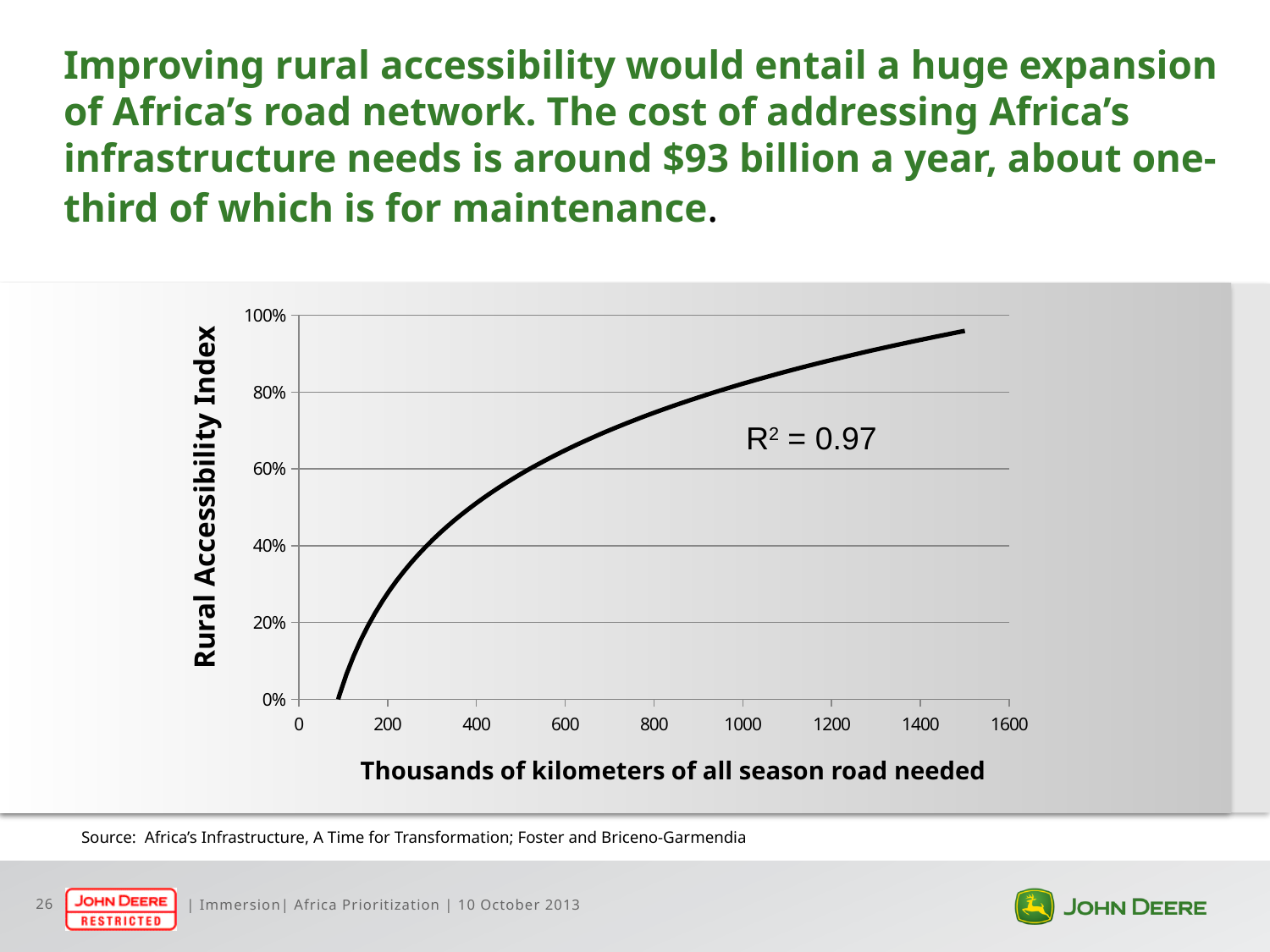
Is the Rural Accessibility Index at 200 thousand kilometers greater or less than 40%? less What is the R² value shown on the chart? R² = 0.97 What is the label of the x axis of the chart? Thousands of kilometers of all season road needed Is the Rural Accessibility Index at 400 thousand kilometers greater or less than 60%? less Is the Rural Accessibility Index at 400 thousand kilometers greater or less than 40%? greater What kind of chart is shown on the slide? line chart Which is larger: the Rural Accessibility Index at 400 thousand kilometers or at 1200 thousand kilometers? 1200 thousand kilometers Does the Rural Accessibility Index rise or fall as the thousands of kilometers of all season road needed increases? rise